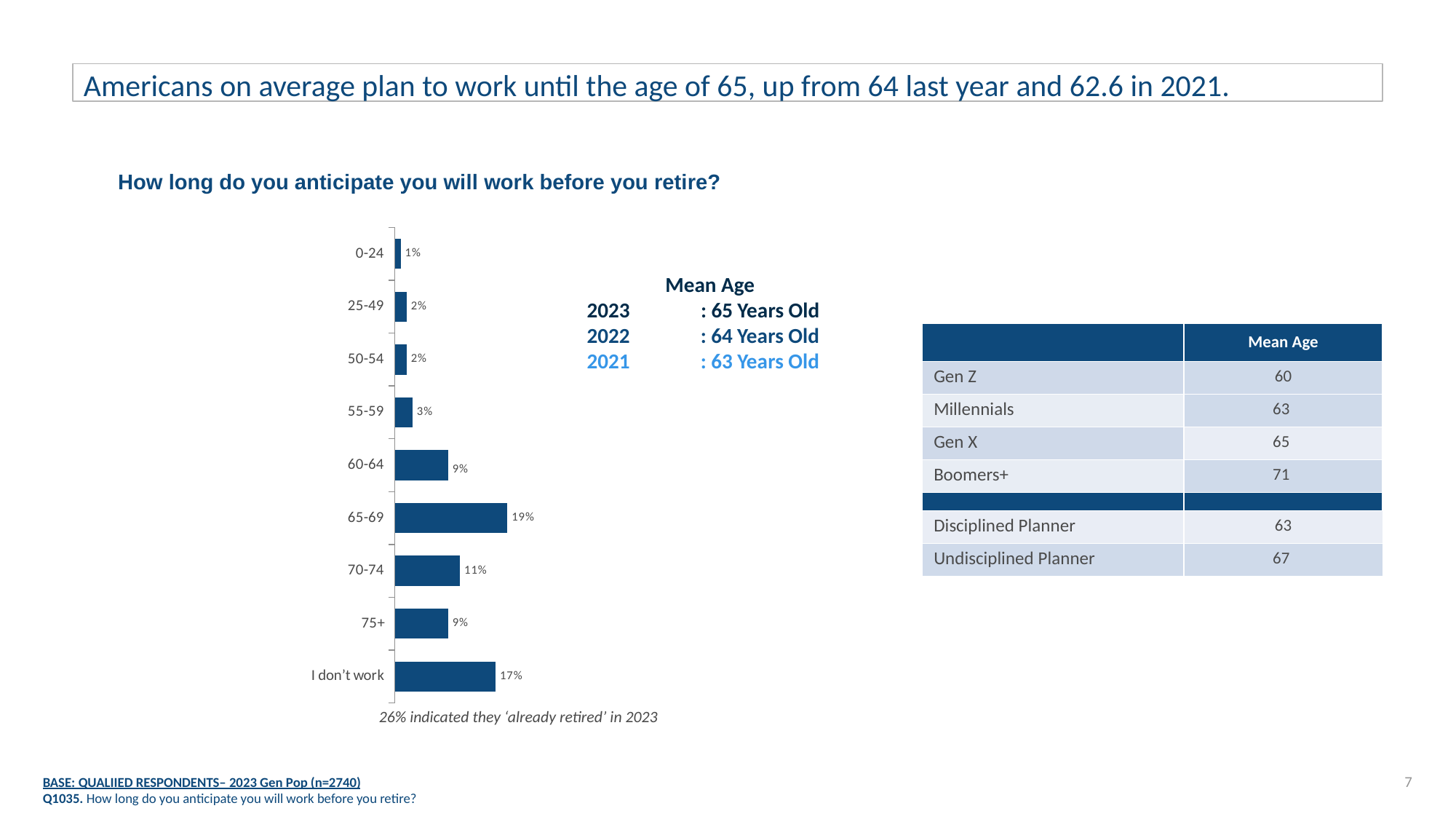
Which is larger, the value for 70-74 or the value for 75+? 70-74 How many categories are shown in the bar chart? 9 What is the value for the 70-74 category? 11% What is the difference between the 65-69 value and the 70-74 value? 8% What percentage of respondents anticipate working until age 65-69 before retiring? 19% Which category has the highest value in the bar chart? 65-69 Which category has the lowest value in the bar chart? 0-24 What kind of chart is shown on the slide? Bar chart What is the value for the 55-59 category? 3% What percentage of respondents said 'I don't work'? 17% What is the title of the chart? How long do you anticipate you will work before you retire? What is the difference between the 'I don't work' value and the 60-64 value? 8%